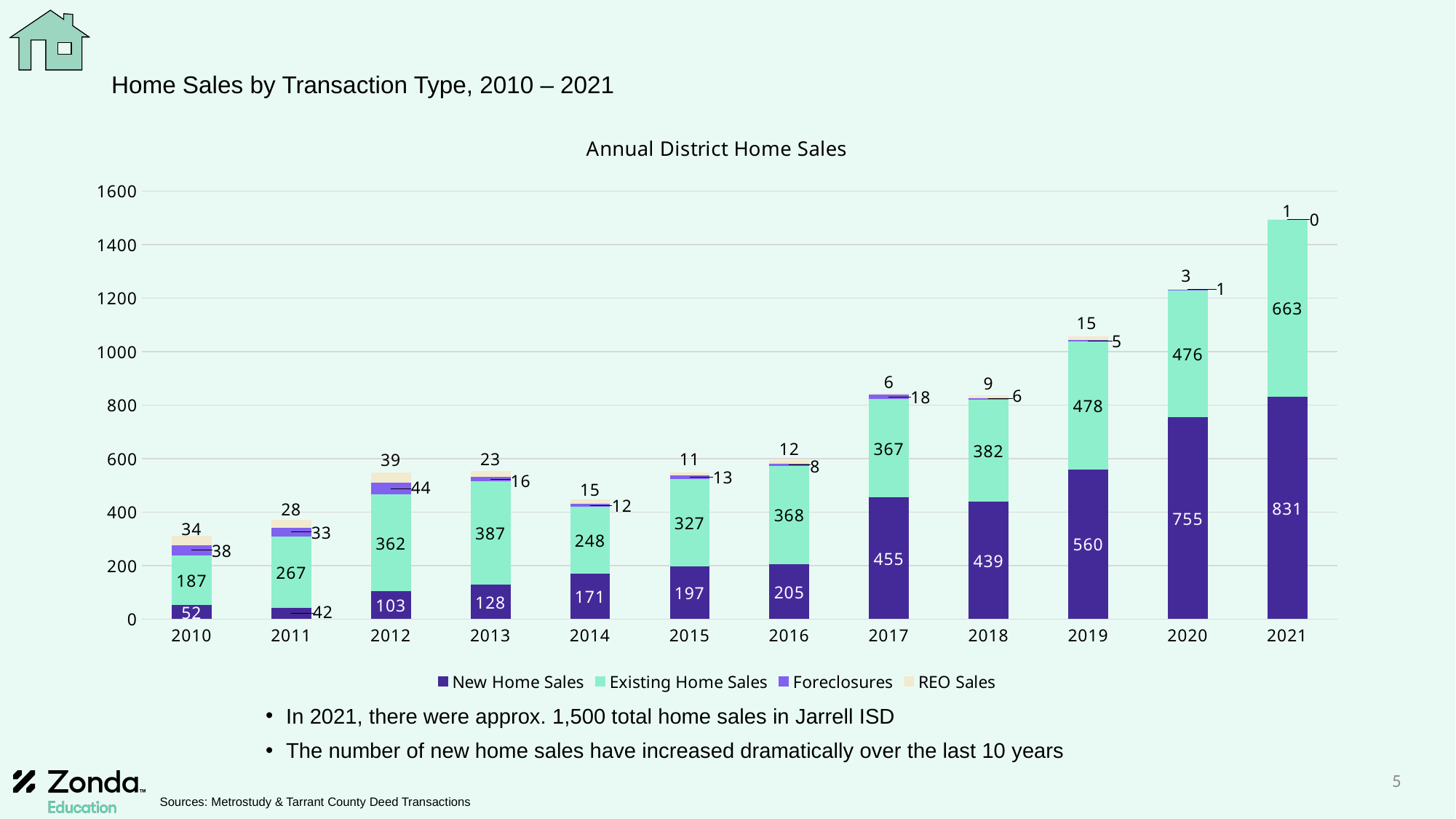
In 2017, which is larger: New Home Sales or Existing Home Sales? New Home Sales How many series does the legend list? 4 What is the total of the 2021 stacked bar? 1495 What is the value of Existing Home Sales in 2013? 387 How many years are shown on the x axis? 12 Which year has the highest New Home Sales? 2021 What is the value of New Home Sales in 2021? 831 Which year has the lowest New Home Sales? 2011 What kind of chart is shown? Stacked bar chart Is the total height of the 2019 bar greater or less than 1000? greater Do New Home Sales generally rise or fall from 2010 to 2021? Rise What is the difference between New Home Sales in 2021 and in 2020? 76